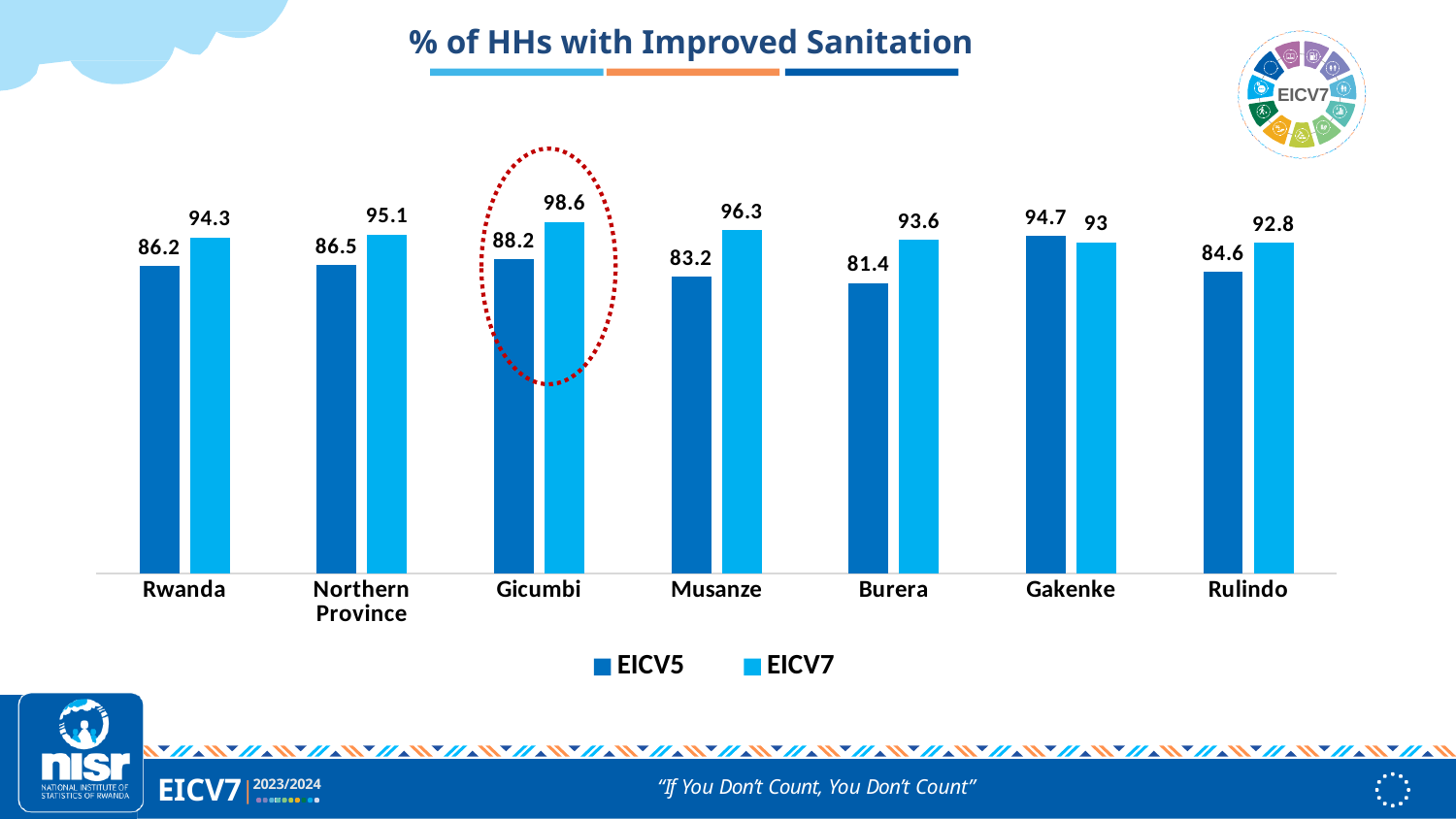
How many series does the legend list? 2 What is the EICV7 value for Gicumbi? 98.6 What is the EICV7 value for Rwanda? 94.3 How many categories are shown on the x axis? 7 What kind of chart is shown on the slide? Bar chart Which category has the highest EICV7 value? Gicumbi Which category has the lowest EICV5 value? Burera Which category is highlighted with a red dotted circle? Gicumbi What is the title of the chart? % of HHs with Improved Sanitation What is the EICV5 value for Burera? 81.4 Which is larger for Gakenke, the EICV5 value or the EICV7 value? EICV5 What is the difference between the EICV7 and EICV5 values for Gicumbi? 10.4